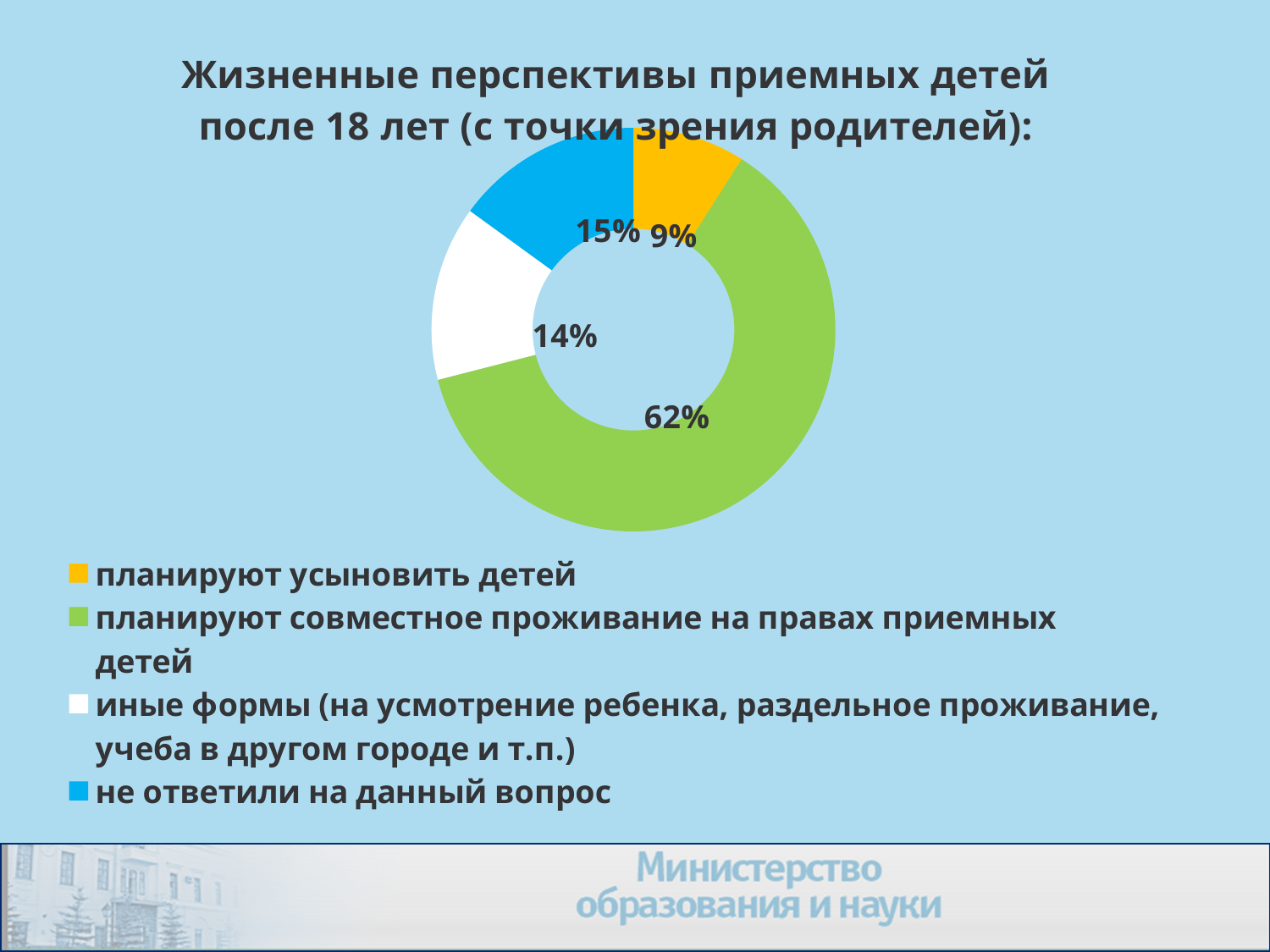
What share of parents plan to adopt the children (планируют усыновить детей)? 9% What colour is the slice for 'планируют усыновить детей'? yellow What share corresponds to 'иные формы' (other forms)? 14% What share of parents plan joint living on the basis of foster children (планируют совместное проживание на правах приемных детей)? 62% Which is larger: the share for 'иные формы' or the share for 'не ответили на данный вопрос'? не ответили на данный вопрос Which category has the smallest share in the chart? планируют усыновить детей What is the title of the chart? Жизненные перспективы приемных детей после 18 лет (с точки зрения родителей): How many categories does the chart show? 4 What kind of chart is shown on the slide? doughnut chart What is the difference in percentage points between 'планируют совместное проживание на правах приемных детей' and 'не ответили на данный вопрос'? 47 What share of parents did not answer the question (не ответили на данный вопрос)? 15% Which category has the largest share in the chart? планируют совместное проживание на правах приемных детей